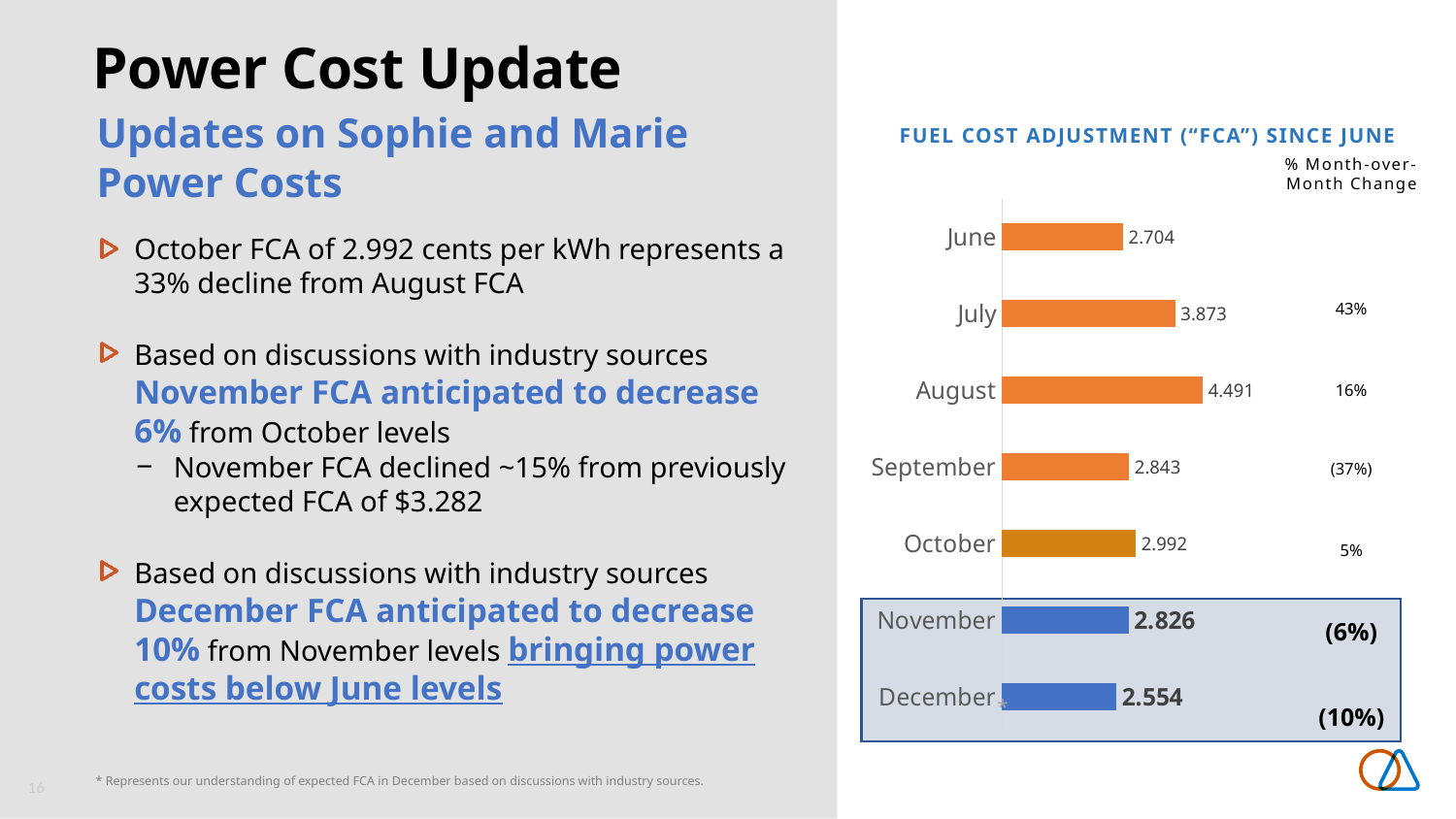
What is the difference between the July and June FCA values? 1.169 What kind of chart is used to show the FCA values? Bar chart How many months are plotted in the chart? 7 What is the title of the chart? FUEL COST ADJUSTMENT ("FCA") SINCE JUNE What is the % month-over-month change shown for September? (37%) Which month has the lowest FCA value in the chart? December What is the FCA value shown for December? 2.554 What is the FCA value shown for August? 4.491 Which month has the highest FCA value in the chart? August Which is larger, the FCA value for September or for October? October Which months' bars are coloured blue rather than orange? November and December What is the % month-over-month change shown for November? (6%)